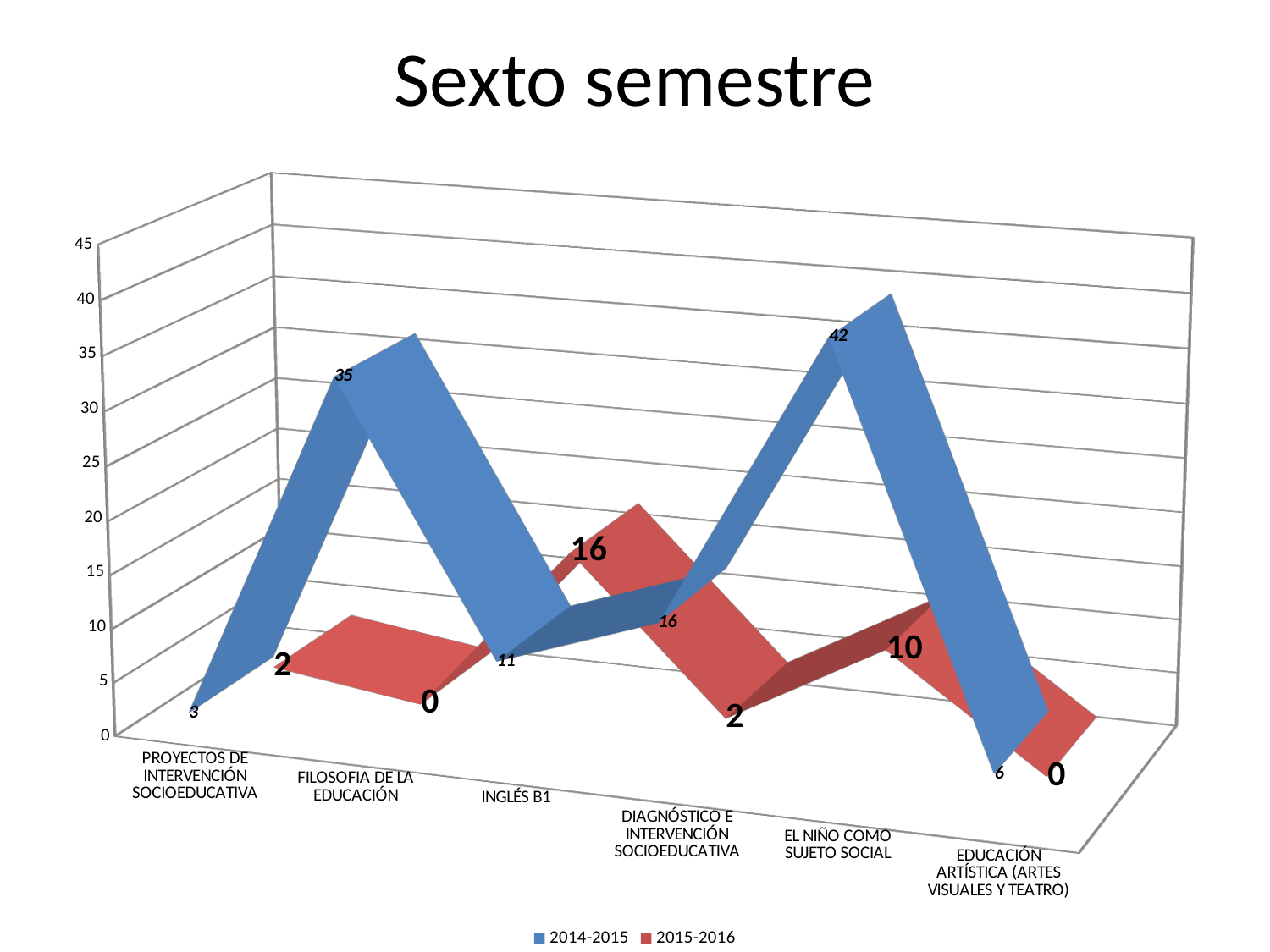
How many categories are shown on the x axis? 6 What is the title of the chart? Sexto semestre Which category has the highest value in the 2015-2016 series? INGLÉS B1 What is the value for INGLÉS B1 in the 2015-2016 series? 16 What is the value for EL NIÑO COMO SUJETO SOCIAL in the 2014-2015 series? 42 For INGLÉS B1, which series has the larger value, 2014-2015 or 2015-2016? 2015-2016 What is the value for FILOSOFIA DE LA EDUCACIÓN in the 2014-2015 series? 35 What is the value for EL NIÑO COMO SUJETO SOCIAL in the 2015-2016 series? 10 How many series does the legend list? 2 What is the difference between the 2014-2015 and 2015-2016 values for EL NIÑO COMO SUJETO SOCIAL? 32 Which category has the lowest value in the 2014-2015 series? PROYECTOS DE INTERVENCIÓN SOCIOEDUCATIVA Which category has the highest value in the 2014-2015 series? EL NIÑO COMO SUJETO SOCIAL